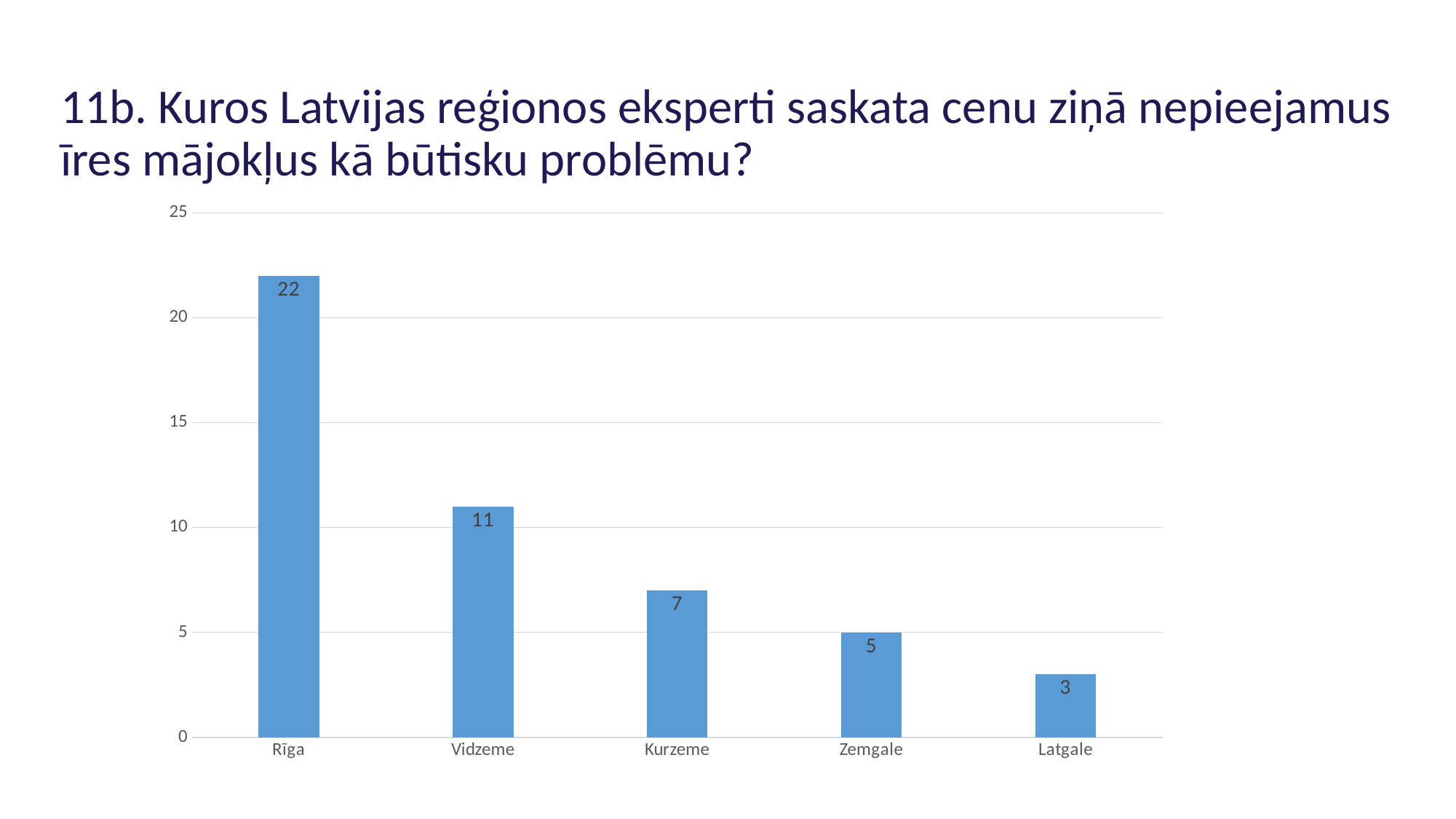
What is the difference between the values for Rīga and Vidzeme? 11 Which region has the highest value? Rīga What is the value for Latgale? 3 What kind of chart is shown on the slide? bar chart What is the value for Kurzeme? 7 Which is larger, the value for Kurzeme or the value for Zemgale? Kurzeme What is the value for Rīga? 22 Do the values rise or fall from Rīga to Latgale along the x axis? fall How many regions are shown on the chart? 5 Is the value for Zemgale greater or less than 10? less Which region has the lowest value? Latgale What is the value for Vidzeme? 11